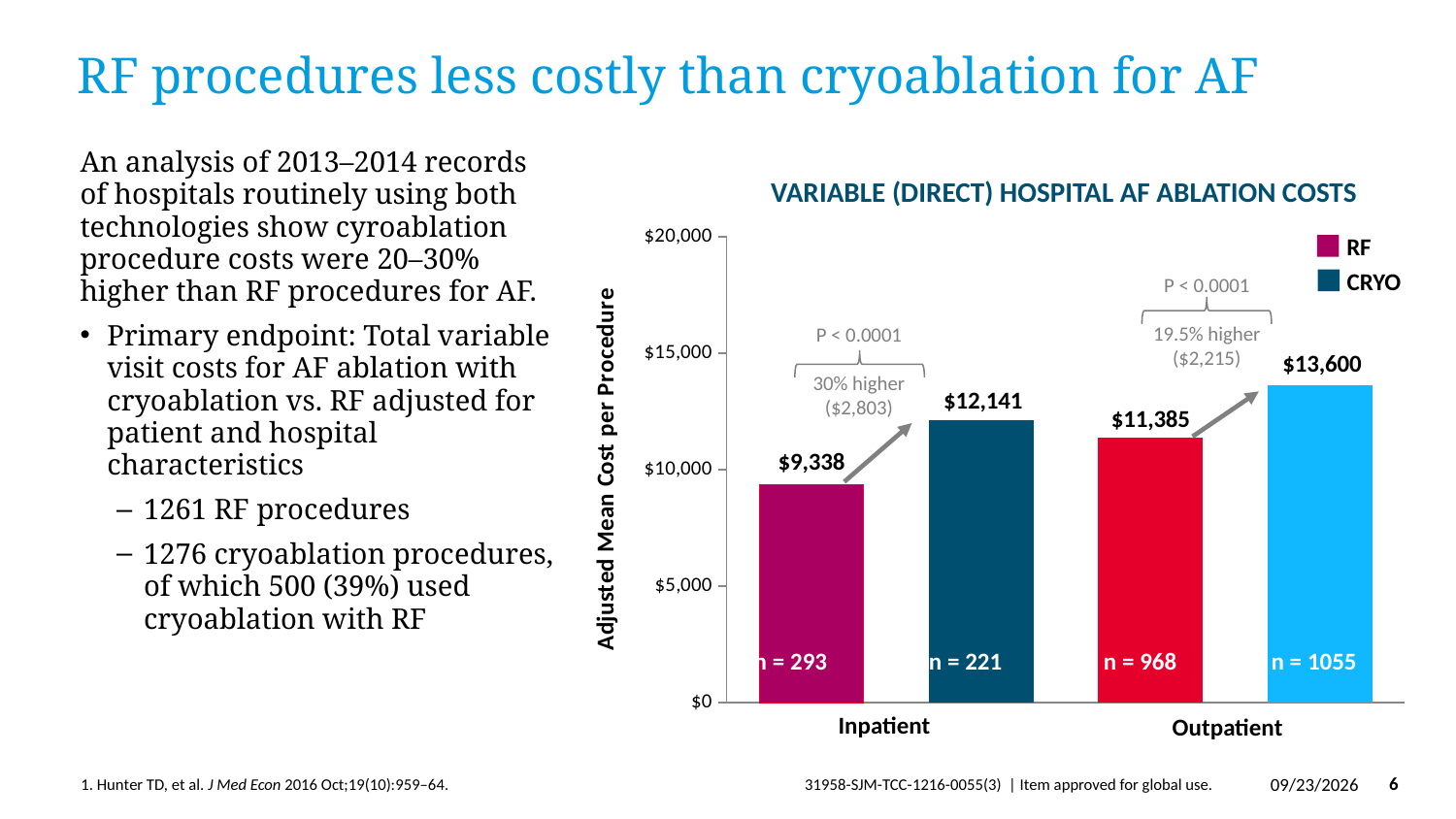
How many series does the legend list? 2 What is the adjusted mean cost per procedure for CRYO in the Outpatient category? $13,600 What is the adjusted mean cost per procedure for CRYO in the Inpatient category? $12,141 Which bar shows the lowest adjusted mean cost per procedure? RF, Inpatient What kind of chart is shown on the slide? Bar chart What is the title of the chart? VARIABLE (DIRECT) HOSPITAL AF ABLATION COSTS Which is larger, the RF cost for Outpatient or the CRYO cost for Inpatient? CRYO cost for Inpatient Which bar shows the highest adjusted mean cost per procedure? CRYO, Outpatient What is the adjusted mean cost per procedure for RF in the Inpatient category? $9,338 What is the adjusted mean cost per procedure for RF in the Outpatient category? $11,385 What is the difference between the CRYO and RF costs in the Outpatient category? $2,215 What is the difference between the CRYO and RF costs in the Inpatient category? $2,803